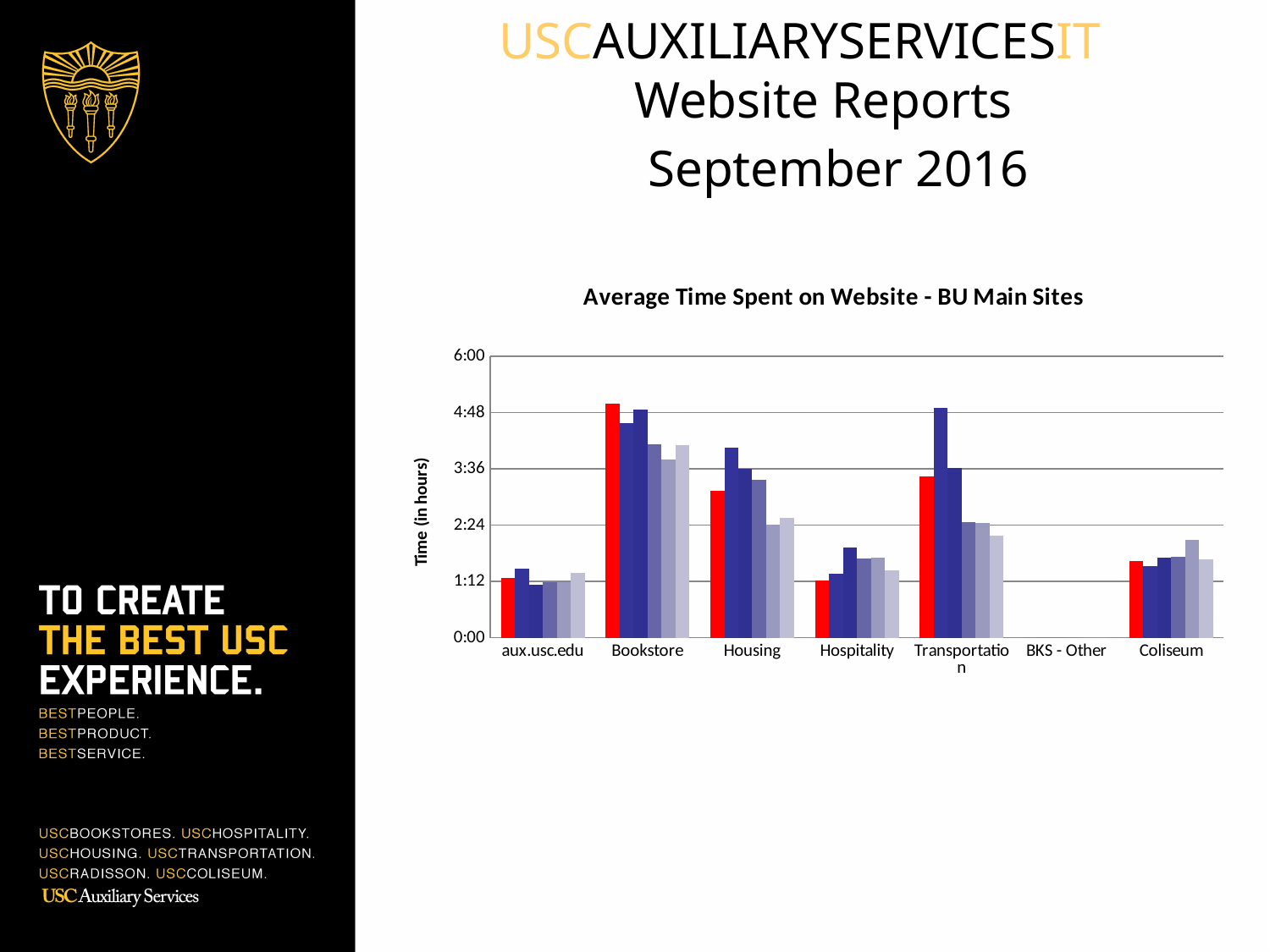
Is the red bar for aux.usc.edu greater or less than 2:24? less Is the red bar for Bookstore greater or less than 3:36? greater How many categories are shown along the x axis of the chart? 7 Which category has the tallest red bar? Bookstore What is the label on the vertical axis of the chart? Time (in hours) Is the red bar for Housing greater or less than 3:36? less What kind of chart is shown on the slide? bar chart Which has a taller red bar, Bookstore or Housing? Bookstore What is the title of the chart? Average Time Spent on Website - BU Main Sites Which category on the x axis has no bars plotted? BKS - Other Which has a taller red bar, Hospitality or Coliseum? Coliseum